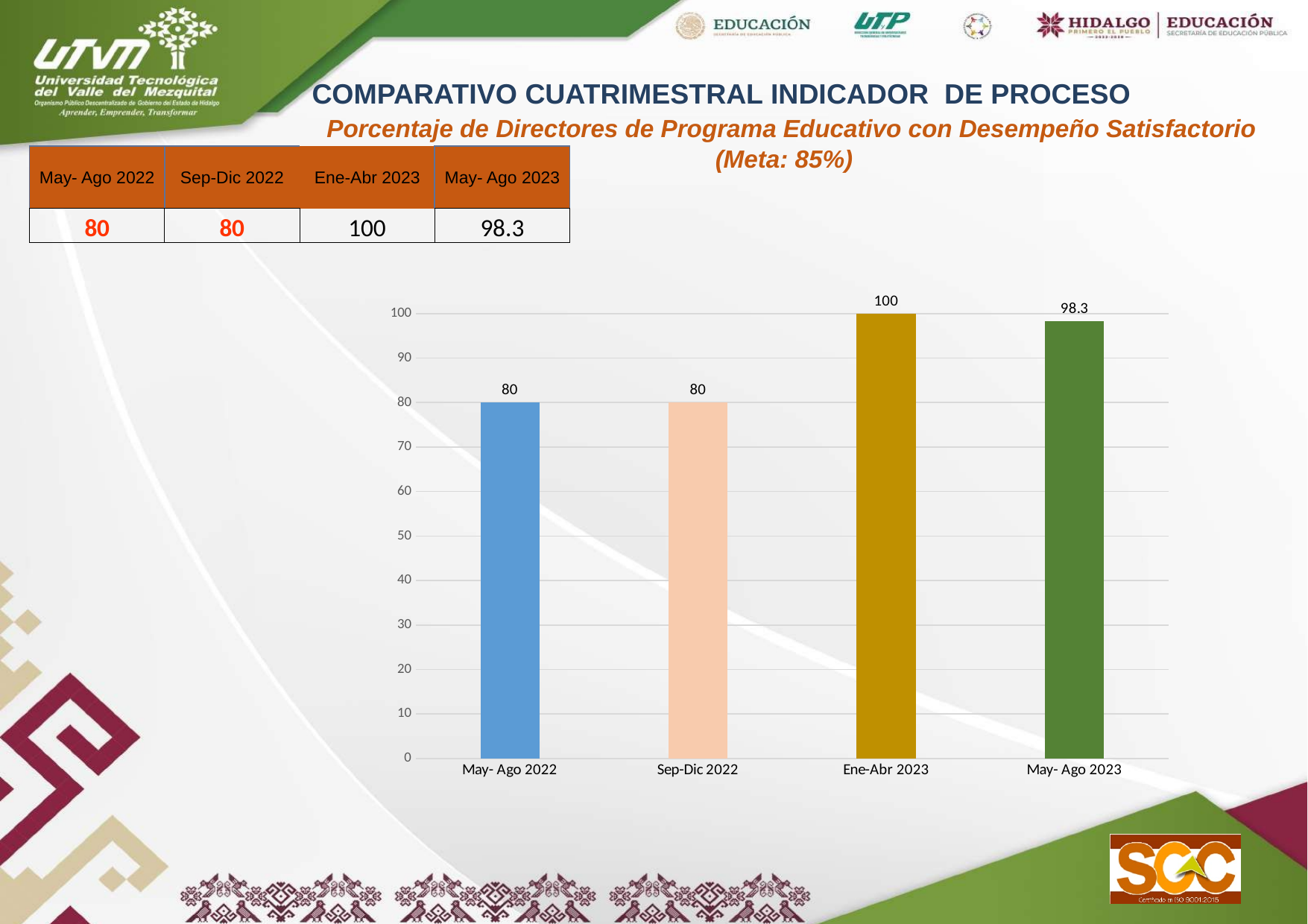
Which is larger, the value for May- Ago 2023 or the value for Sep-Dic 2022? May- Ago 2023 What is the difference between the values for Ene-Abr 2023 and May- Ago 2023? 1.7 How many periods are shown on the x axis of the chart? 4 What is the target (Meta) stated in the chart subtitle? 85% What is the value for May- Ago 2023? 98.3 Which period has the highest value? Ene-Abr 2023 What is the value for Ene-Abr 2023? 100 What is the value for Sep-Dic 2022? 80 Is the value for May- Ago 2022 greater or less than 90? less What is the difference between the values for Ene-Abr 2023 and May- Ago 2022? 20 Do the values generally rise or fall from May- Ago 2022 to Ene-Abr 2023? rise What kind of chart is shown on the slide? bar chart